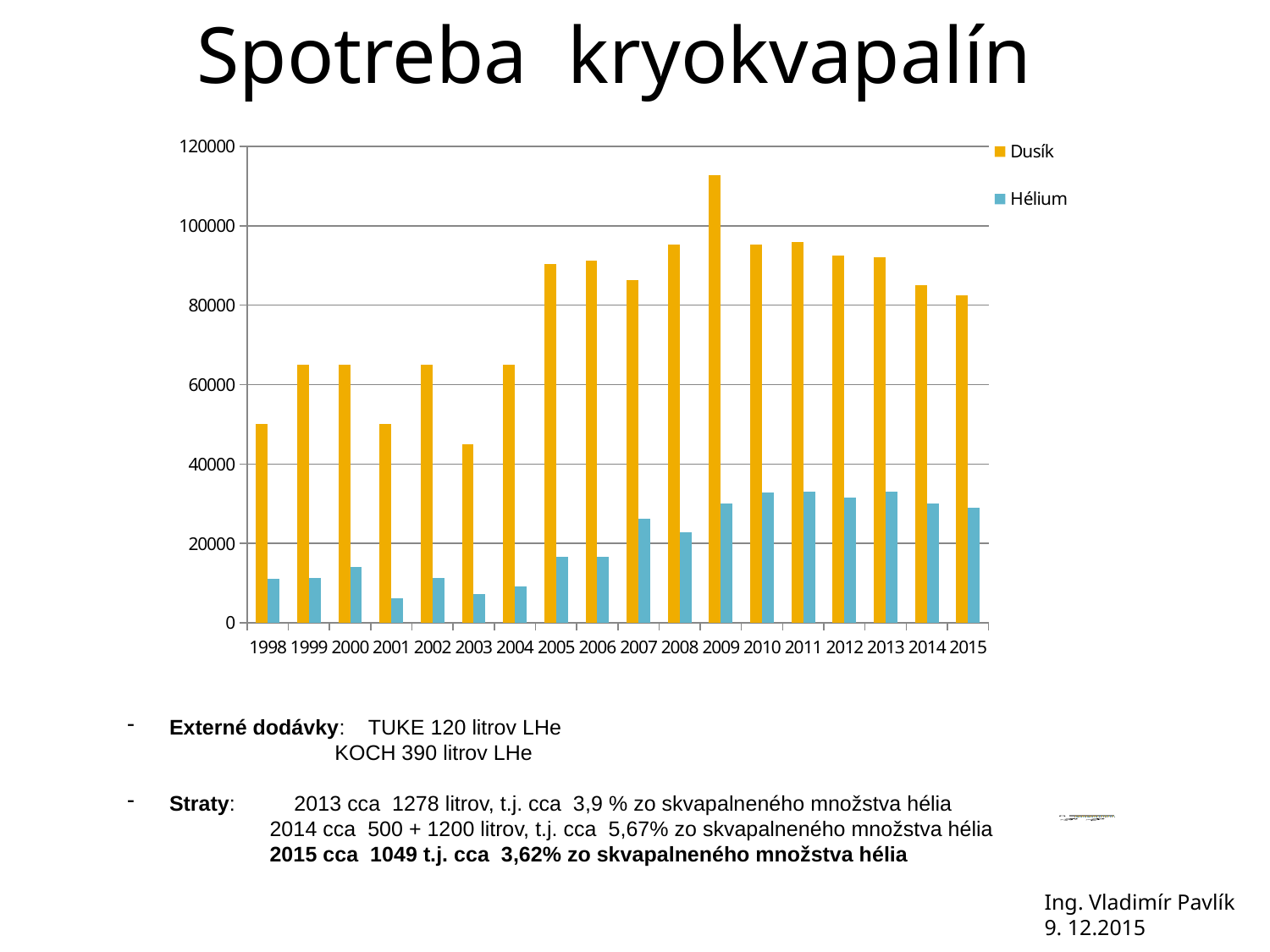
What kind of chart is shown on the slide? bar chart Does the Hélium series generally rise or fall from 1998 to 2015? rise How many series does the chart legend list? 2 How many years are shown on the x axis of the chart? 18 Is the Dusík value for 2009 greater or less than 100000? greater In which year is the Dusík value highest? 2009 Is the Hélium value for 2001 greater or less than 10000? less Which is larger, the Dusík value for 2005 or for 1998? 2005 In which year is the Hélium value lowest? 2001 In which year is the Dusík value lowest? 2003 Which series is shown in orange in the chart? Dusík Is the Dusík value for 2003 greater or less than 60000? less